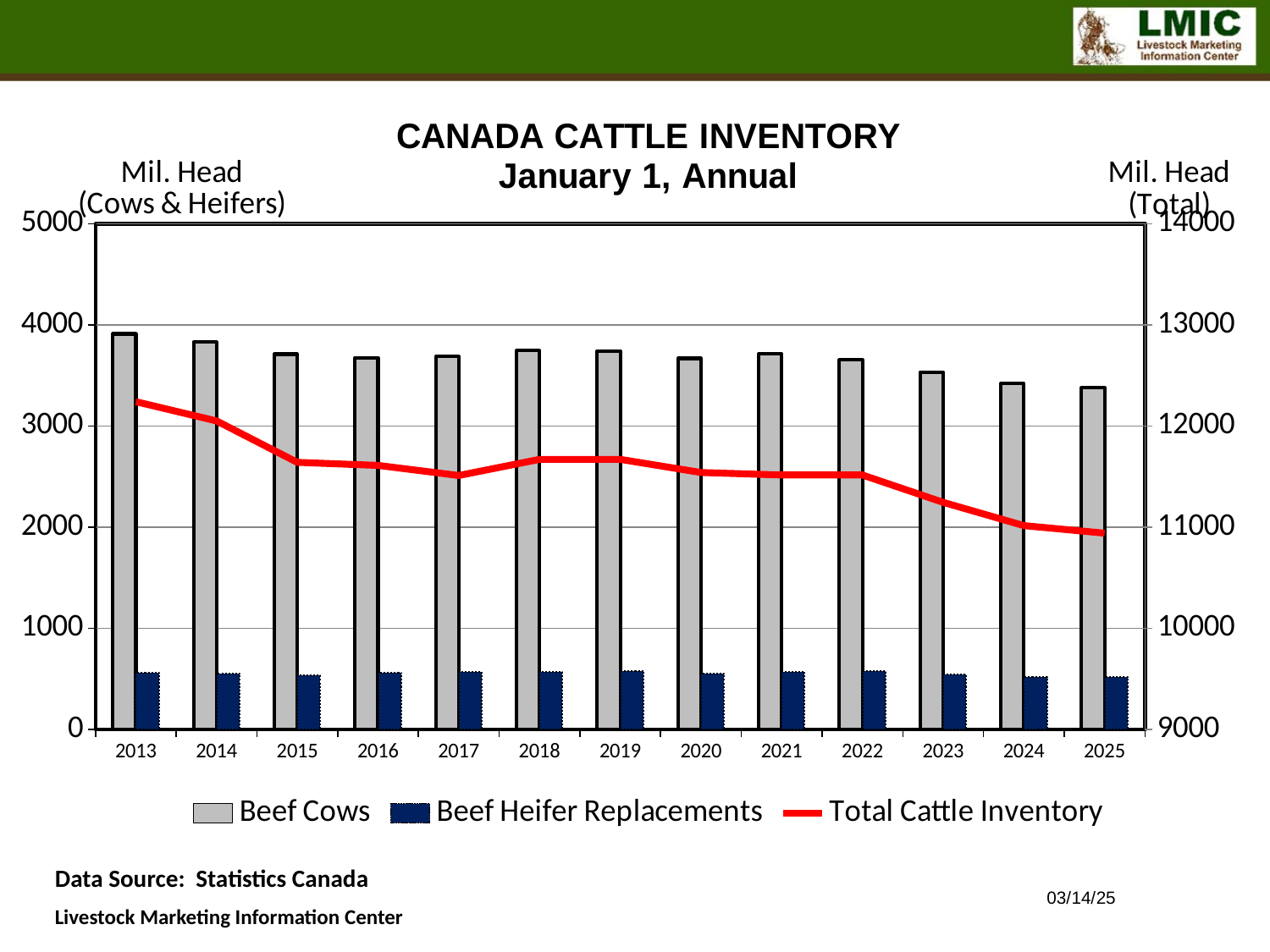
Is the Beef Heifer Replacements value for 2019 greater or less than 1000? less In which year is the Total Cattle Inventory line at its highest? 2013 Which is larger, the Beef Cows value for 2013 or for 2025? 2013 What kind of chart is shown on the slide? A combined bar and line chart What is the title of the chart? CANADA CATTLE INVENTORY January 1, Annual Which series is drawn as a red line? Total Cattle Inventory How many series does the chart's legend list? 3 How many years are shown along the x axis of the chart? 13 Is the Beef Cows value for 2013 greater or less than 3000? greater Does the Total Cattle Inventory line generally rise or fall from 2013 to 2025? fall Is the Total Cattle Inventory value for 2013 greater or less than 12000? greater In which year is the Beef Cows bar the tallest? 2013